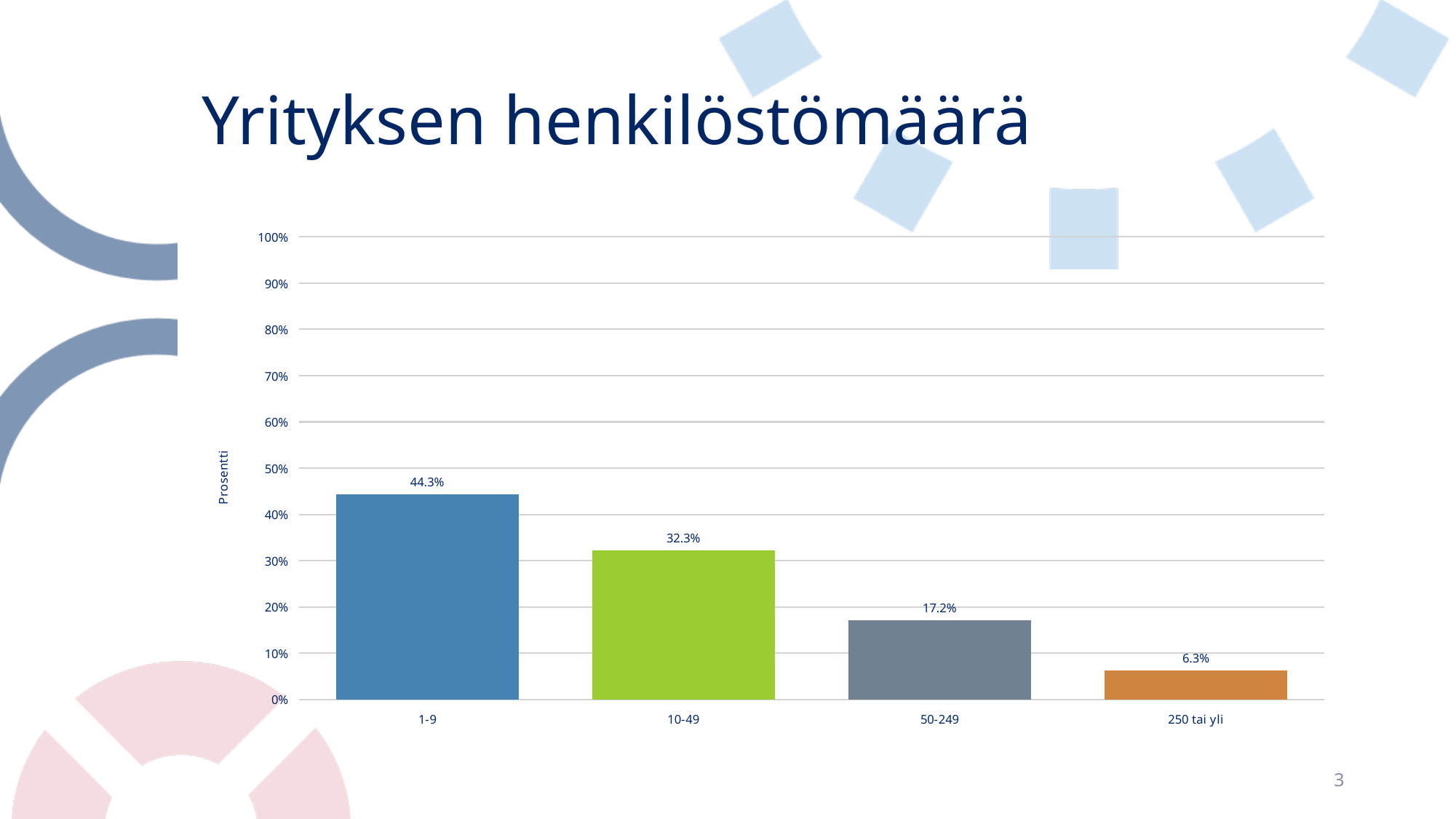
Is the value for 50-249 greater or less than 20%? less What is the value for the 1-9 category? 44.3% What is the value for the 50-249 category? 17.2% Which category has the lowest value? 250 tai yli What is the value for the 10-49 category? 32.3% Which is larger, the value for 10-49 or the value for 50-249? 10-49 How many categories are shown on the x axis? 4 What is the value for the '250 tai yli' category? 6.3% What kind of chart is shown on the slide? bar chart Which category has the highest value? 1-9 What is the difference between the values for 1-9 and 10-49? 12.0% What is the label of the vertical axis? Prosentti